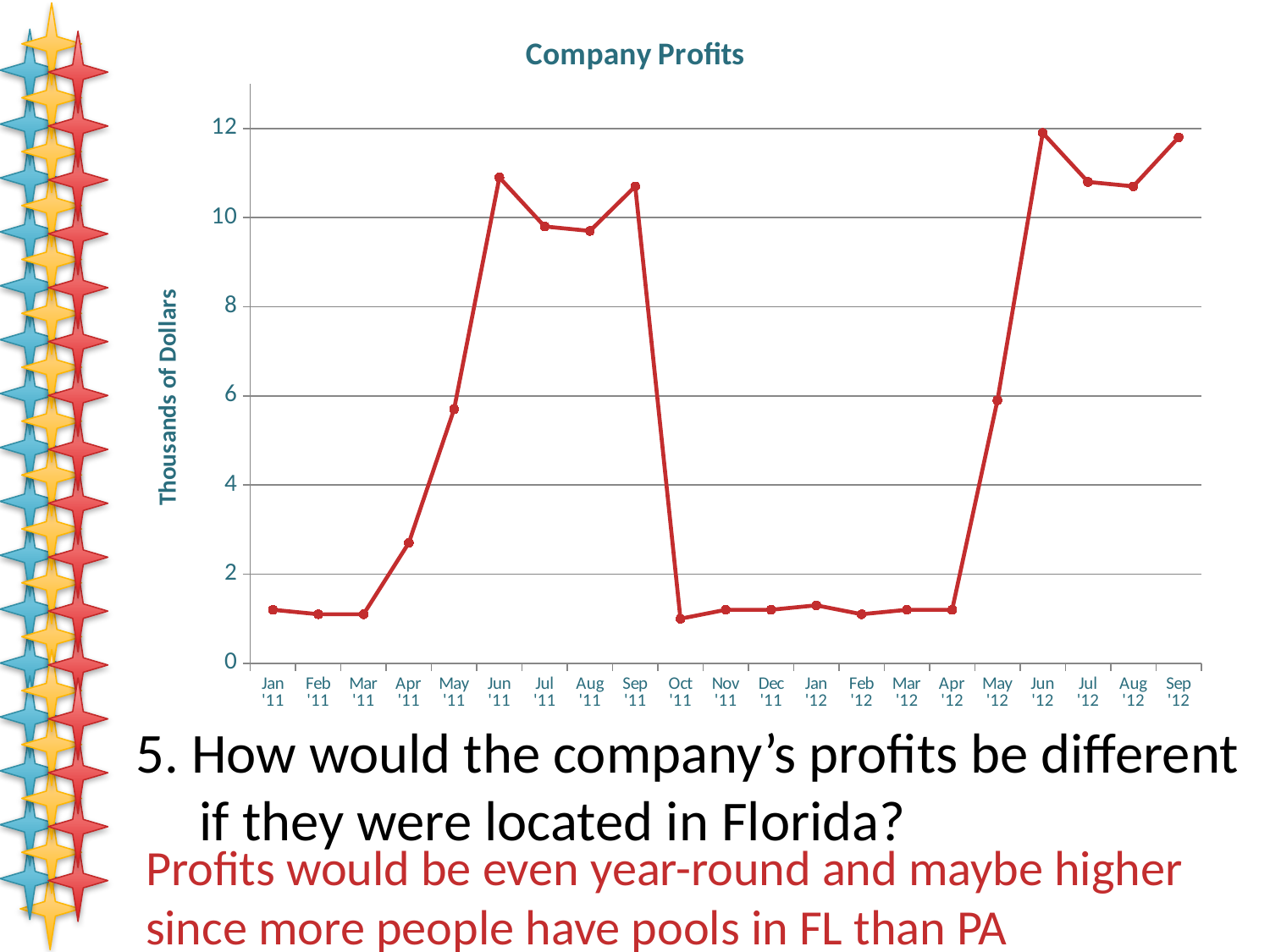
Is the value for Oct '11 greater or less than 2? less What is the title of the chart? Company Profits Is the value for Jan '12 greater or less than 2? less Is the value for May '11 greater or less than 6? less Which is higher, the value for Jun '11 or the value for Jul '11? Jun '11 What is the label on the vertical axis of the chart? Thousands of Dollars Do the values rise or fall from Mar '11 to Jun '11? rise Which is higher, the value for Sep '11 or the value for Oct '11? Sep '11 How many months are plotted along the x axis of the chart? 21 What kind of chart is shown on the slide? line chart